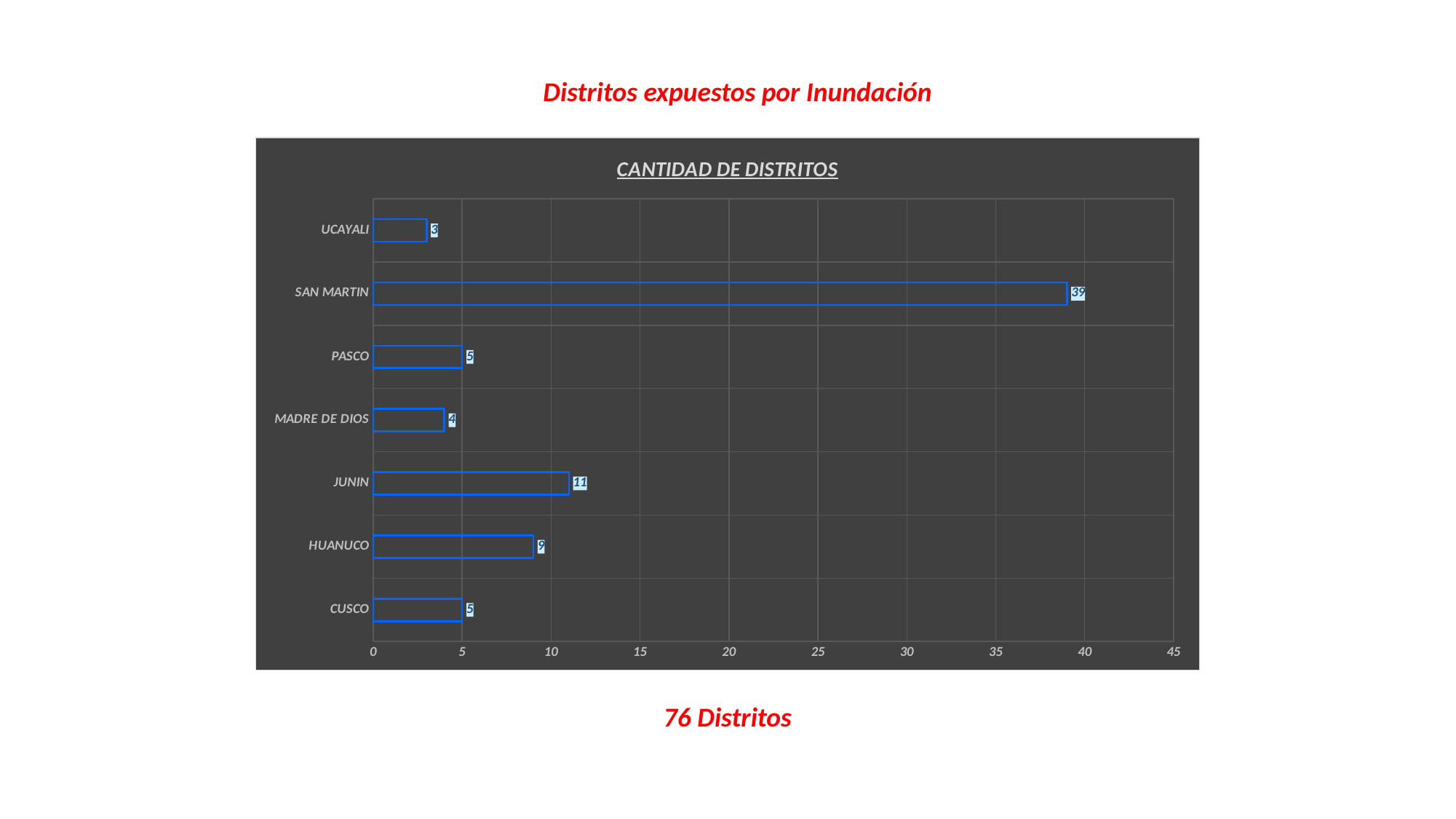
Is the value for SAN MARTIN greater or less than 35? greater What kind of chart is shown on the slide? bar chart How many categories are shown in the chart? 7 Which is larger, the value for JUNIN or the value for HUANUCO? JUNIN What is the value for JUNIN? 11 What is the title of the chart? CANTIDAD DE DISTRITOS Which category has the highest value? SAN MARTIN What is the difference between the values for SAN MARTIN and JUNIN? 28 What is the value for HUANUCO? 9 What is the value for MADRE DE DIOS? 4 What is the value for SAN MARTIN? 39 Which category has the lowest value? UCAYALI